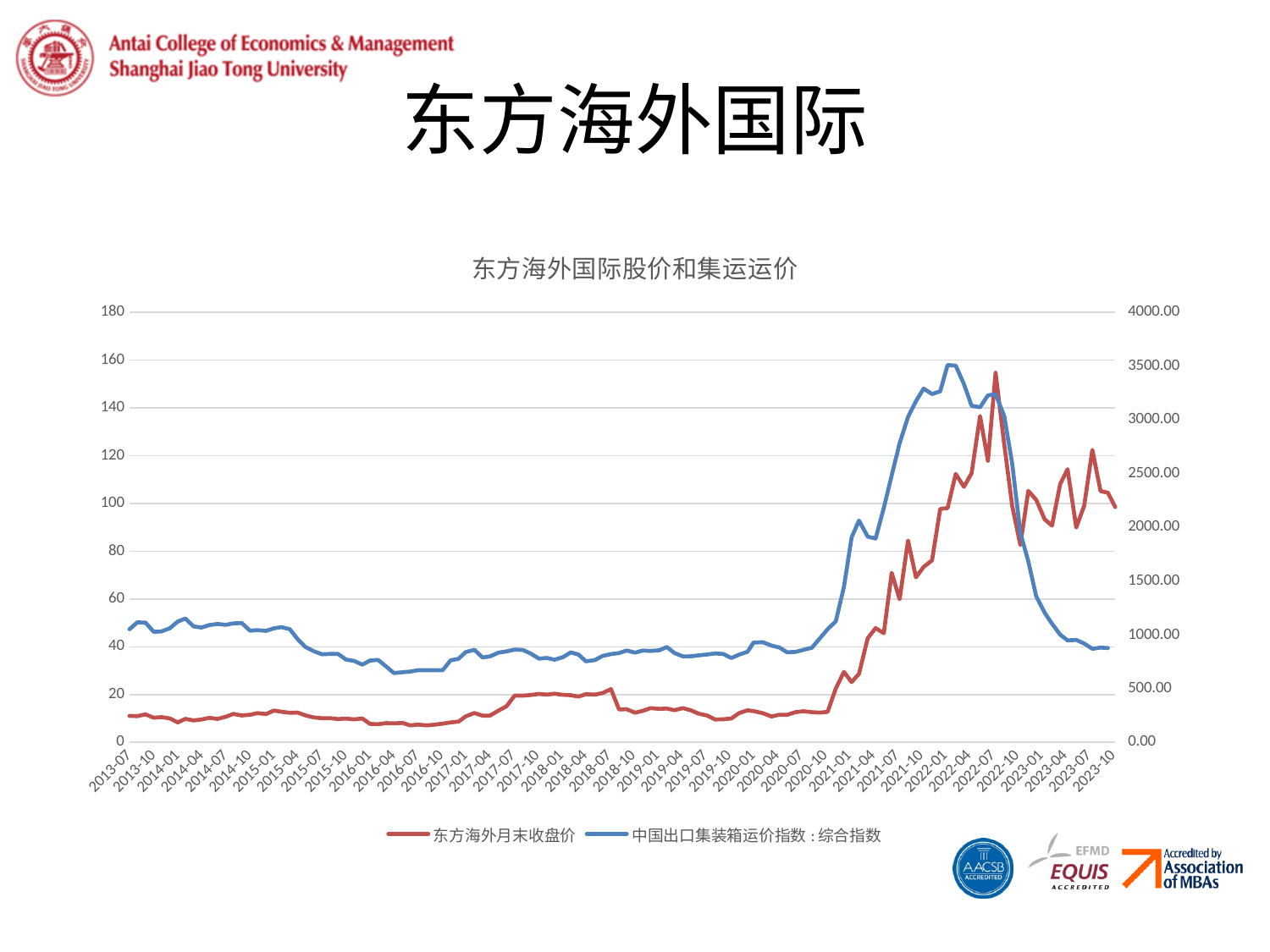
Is the value of 东方海外月末收盘价 at 2023-07 greater or less than 100? greater Is the value of 中国出口集装箱运价指数:综合指数 at 2016-04 greater or less than 1000.00? less What kind of chart is shown on the slide? line chart Which series is drawn in red according to the legend? 东方海外月末收盘价 Is the value of 中国出口集装箱运价指数:综合指数 at 2023-10 greater or less than 1000.00? less How many series does the legend list? 2 Does the 中国出口集装箱运价指数:综合指数 line rise or fall between 2022-01 and 2023-10? fall Does the 东方海外月末收盘价 line rise or fall between 2020-10 and 2022-07? rise What is the title of the chart? 东方海外国际股价和集运运价